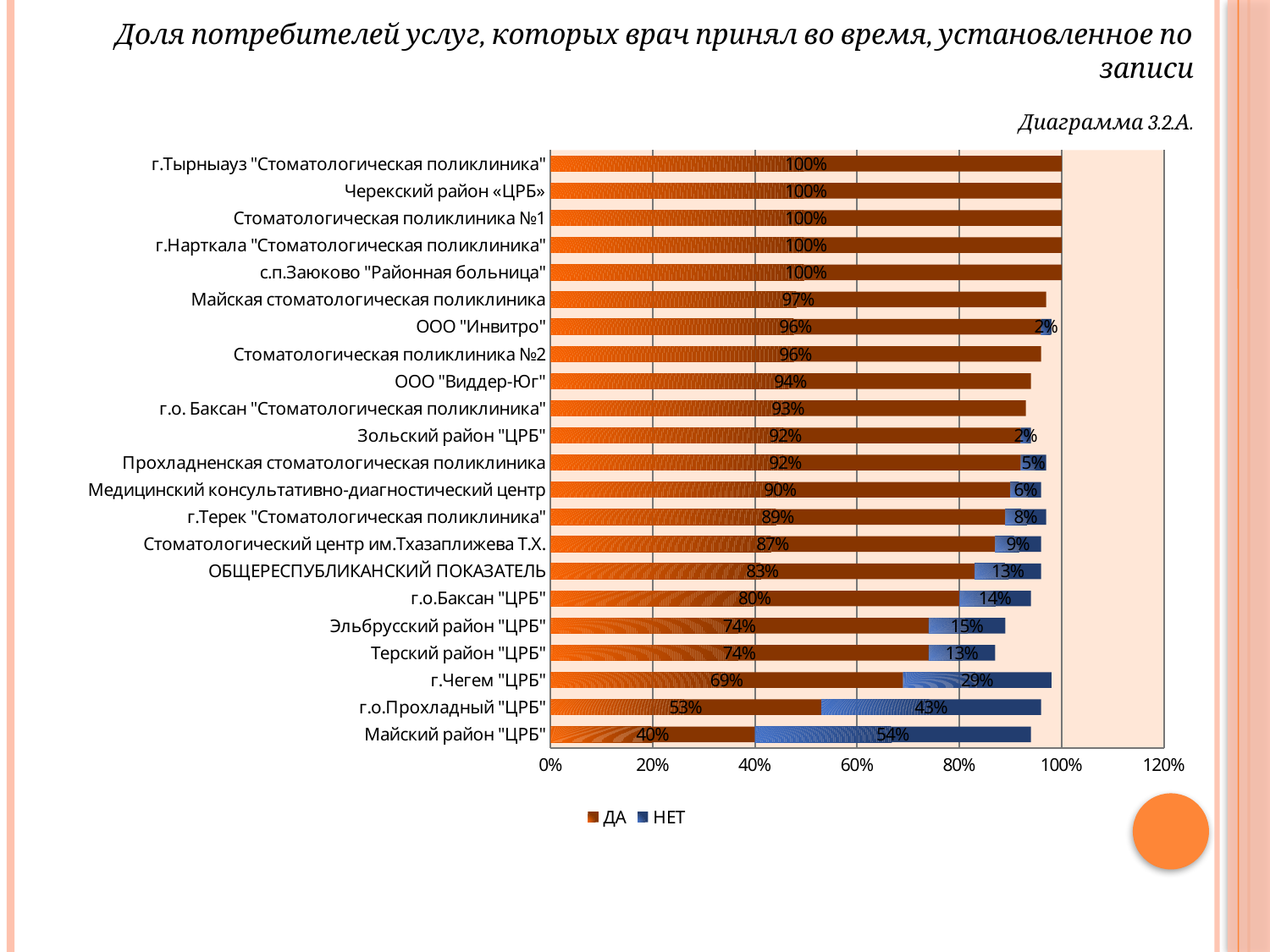
What is the ДА value for ОБЩЕРЕСПУБЛИКАНСКИЙ ПОКАЗАТЕЛЬ? 83% How many series does the legend list? 2 What is the НЕТ value for г.Чегем "ЦРБ"? 29% How many categories are shown on the chart? 22 Which category has the lowest ДА value? Майский район "ЦРБ" What is the total of the stacked bar for Майский район "ЦРБ"? 94% What is the НЕТ value for г.о.Прохладный "ЦРБ"? 43% Which has a larger ДА value: г.о.Баксан "ЦРБ" or Эльбрусский район "ЦРБ"? г.о.Баксан "ЦРБ" What kind of chart is shown on the slide? Stacked bar chart What is the ДА value for Майский район "ЦРБ"? 40% What is the difference between the ДА values for Терский район "ЦРБ" and г.Чегем "ЦРБ"? 5% Which category has the highest НЕТ value? Майский район "ЦРБ"